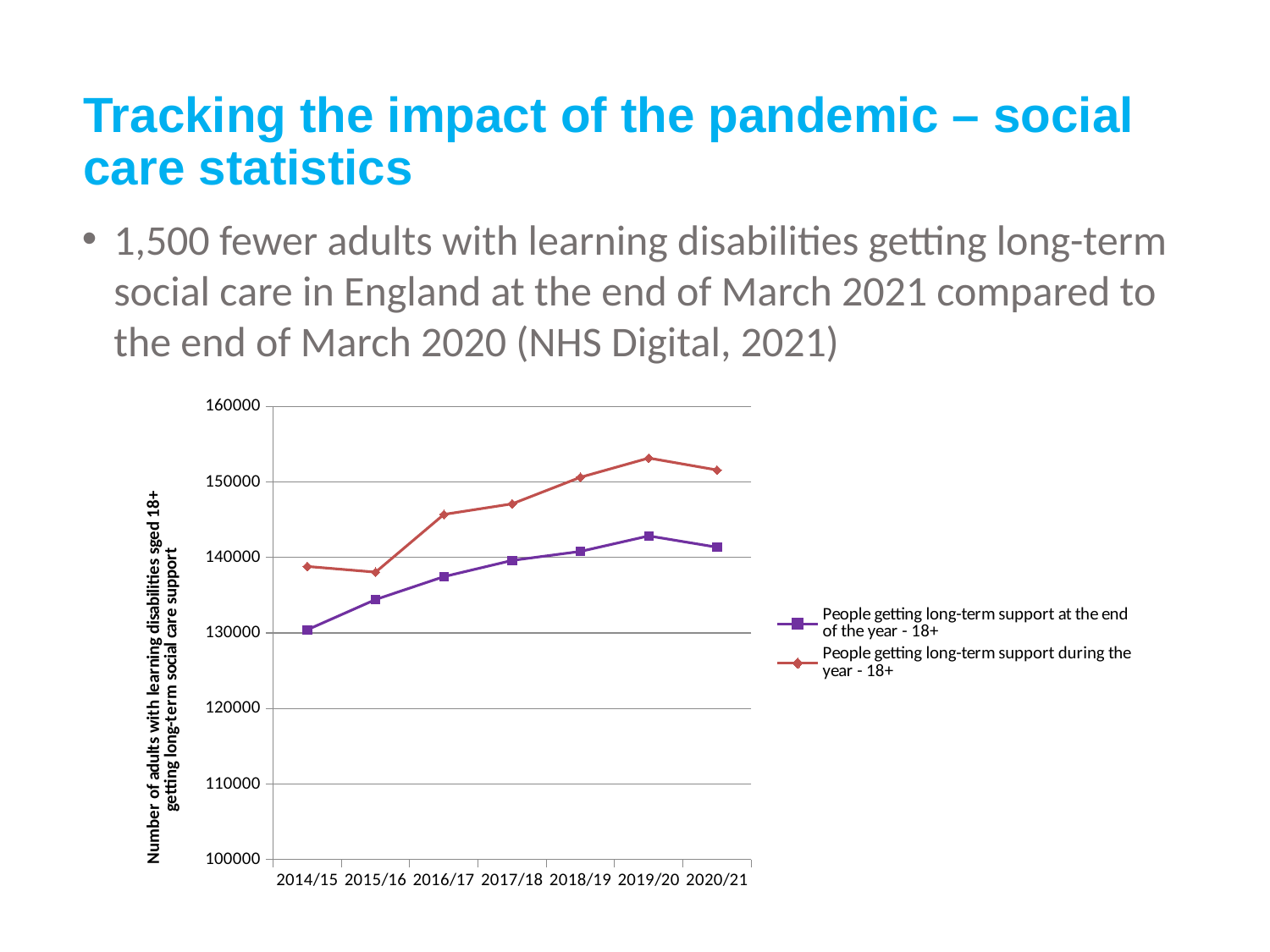
In which year does the series 'People getting long-term support at the end of the year - 18+' reach its highest value? 2019/20 In which year does the series 'People getting long-term support during the year - 18+' reach its highest value? 2019/20 Is the value for 'People getting long-term support at the end of the year - 18+' in 2016/17 greater or less than 140000? less Is the value for 'People getting long-term support during the year - 18+' in 2019/20 greater or less than 150000? greater How many series does the chart legend list? 2 Does the series 'People getting long-term support at the end of the year - 18+' rise or fall between 2019/20 and 2020/21? Fall How many years are plotted along the x axis of the chart? 7 Is the value for 'People getting long-term support at the end of the year - 18+' in 2019/20 greater or less than 140000? greater In 2016/17, which series has the larger value: 'People getting long-term support during the year - 18+' or 'People getting long-term support at the end of the year - 18+'? People getting long-term support during the year - 18+ What kind of chart is shown on the slide? Line chart In which year is the series 'People getting long-term support at the end of the year - 18+' at its lowest value? 2014/15